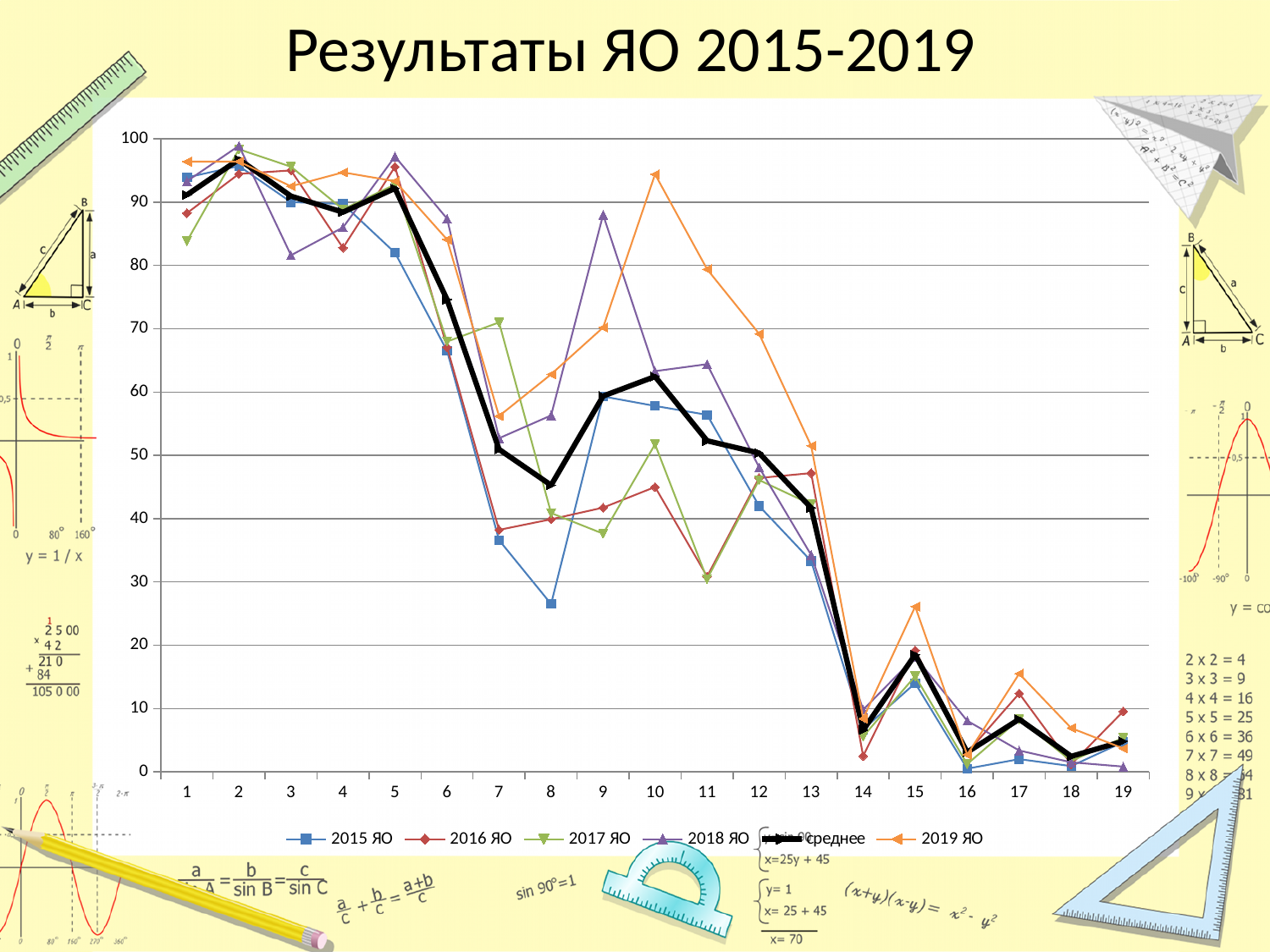
What kind of chart is shown on the slide? line chart How many points are there along the x axis? 19 How many series does the legend list? 6 Is the value for 2019 ЯО at point 15 greater or less than 20? greater Is the value for среднее at point 14 greater or less than 10? less Which series has the lowest value at point 8? 2015 ЯО Do the values generally rise or fall along the x axis from 1 to 19? fall Which series has the highest value at point 10? 2019 ЯО At point 7, which is larger: 2017 ЯО or 2015 ЯО? 2017 ЯО At point 9, which is larger: 2018 ЯО or 2016 ЯО? 2018 ЯО Is the value for 2015 ЯО at point 8 greater or less than 30? less